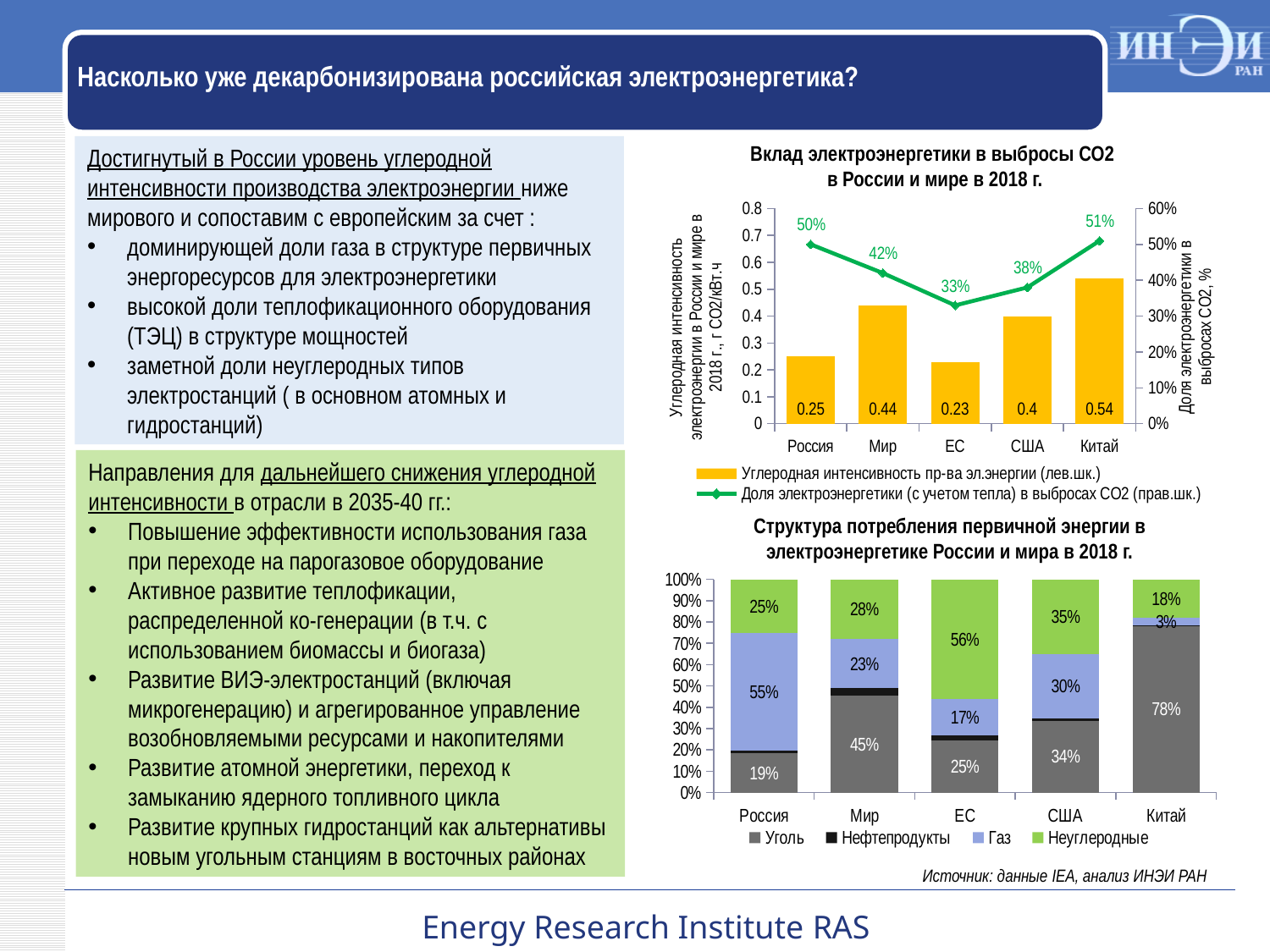
In the chart 'Вклад электроэнергетики в выбросы CO2 в России и мире в 2018 г.', how many series does the legend list? 2 In the chart 'Вклад электроэнергетики в выбросы CO2 в России и мире в 2018 г.', which has the higher share of electricity in CO2 emissions, США or ЕС? США In the chart 'Структура потребления первичной энергии в электроэнергетике России и мира в 2018 г.', what is the share of Газ for Россия? 55% In the chart 'Вклад электроэнергетики в выбросы CO2 в России и мире в 2018 г.', what is the share of electricity in CO2 emissions for Россия? 50% In the chart 'Вклад электроэнергетики в выбросы CO2 в России и мире в 2018 г.', what is the carbon intensity value for Китай? 0.54 In the chart 'Вклад электроэнергетики в выбросы CO2 в России и мире в 2018 г.', what is the difference in carbon intensity between Мир and Россия? 0.19 In the chart 'Структура потребления первичной энергии в электроэнергетике России и мира в 2018 г.', how many series does the legend list? 4 In the chart 'Вклад электроэнергетики в выбросы CO2 в России и мире в 2018 г.', which category has the lowest carbon intensity bar? ЕС In the chart 'Вклад электроэнергетики в выбросы CO2 в России и мире в 2018 г.', how many categories are shown on the x axis? 5 In the chart 'Структура потребления первичной энергии в электроэнергетике России и мира в 2018 г.', which category has the highest share of Неуглеродные? ЕС In the chart 'Структура потребления первичной энергии в электроэнергетике России и мира в 2018 г.', what is the share of Уголь for Китай? 78% What type of chart is 'Структура потребления первичной энергии в электроэнергетике России и мира в 2018 г.'? Stacked bar chart